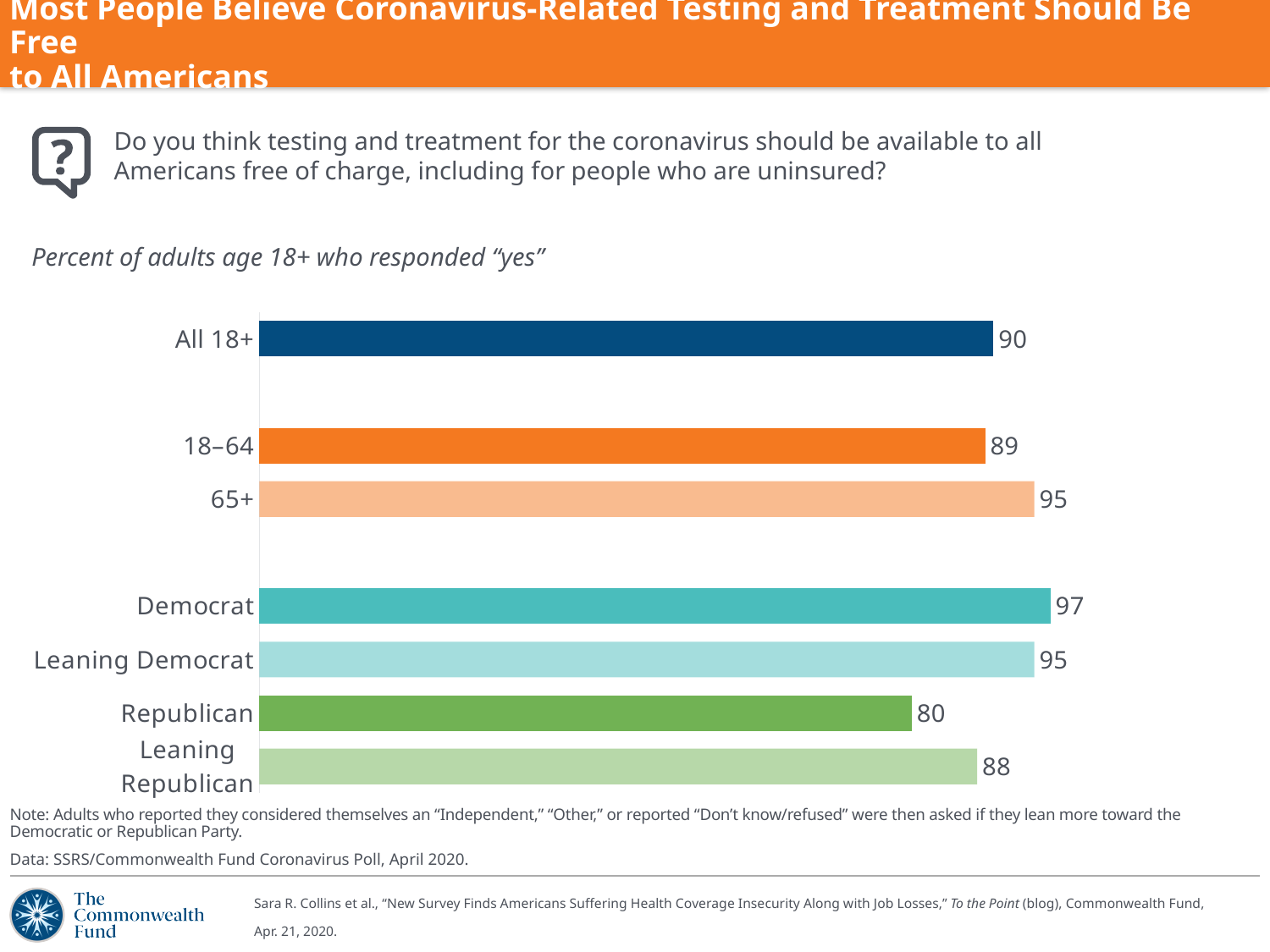
What percent of all adults age 18+ responded "yes"? 90 Which is larger, the value for Leaning Democrat or the value for Leaning Republican? Leaning Democrat What is the difference between the values for Democrat and Republican? 17 What kind of chart is shown on the slide? Bar chart What is the value for Republican? 80 What is the difference between the values for 65+ and 18–64? 6 What does the chart's subtitle say is being measured? Percent of adults age 18+ who responded "yes" How many categories are shown in the chart? 7 Which category has the highest value? Democrat What is the value for adults 65+? 95 Which category has the lowest value? Republican What is the value for Leaning Republican? 88